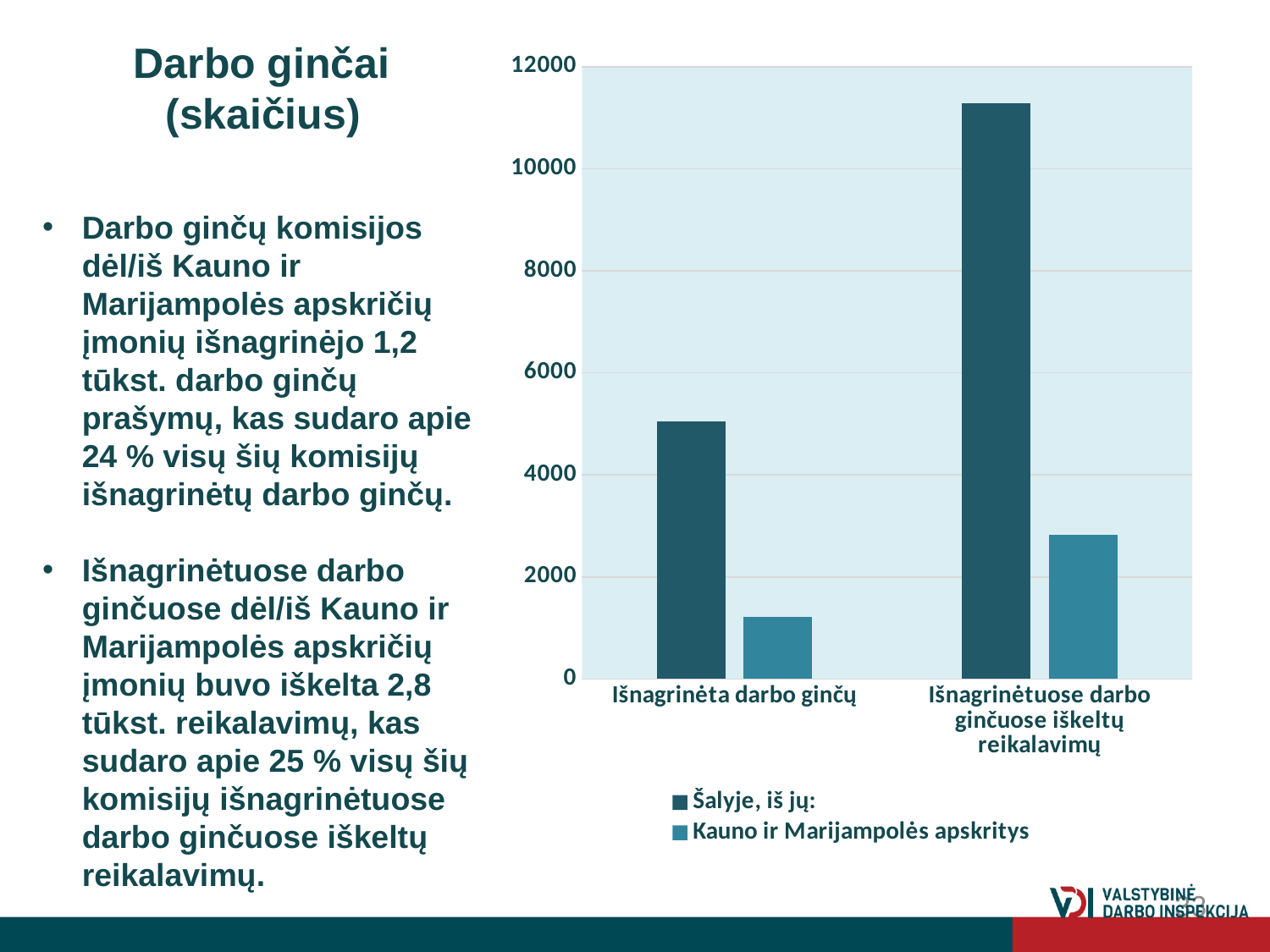
Which series has the tallest bar in the chart? Šalyje, iš jų: Is the value for Kauno ir Marijampolės apskritys in the Išnagrinėta darbo ginčų category greater or less than 2000? less Is the value for Šalyje, iš jų: in the Išnagrinėtuose darbo ginčuose iškeltų reikalavimų category greater or less than 10000? greater What kind of chart is shown on the slide? bar chart Which is larger: the Šalyje, iš jų: value for Išnagrinėta darbo ginčų or the Šalyje, iš jų: value for Išnagrinėtuose darbo ginčuose iškeltų reikalavimų? Išnagrinėtuose darbo ginčuose iškeltų reikalavimų What is the highest value shown on the chart's vertical axis? 12000 Is the value for Kauno ir Marijampolės apskritys in the Išnagrinėtuose darbo ginčuose iškeltų reikalavimų category greater or less than 2000? greater Which bar in the chart is the lowest? Kauno ir Marijampolės apskritys for Išnagrinėta darbo ginčų Which is larger in the Išnagrinėta darbo ginčų category: Šalyje, iš jų: or Kauno ir Marijampolės apskritys? Šalyje, iš jų: How many series does the chart legend list? 2 How many categories are shown on the x axis of the chart? 2